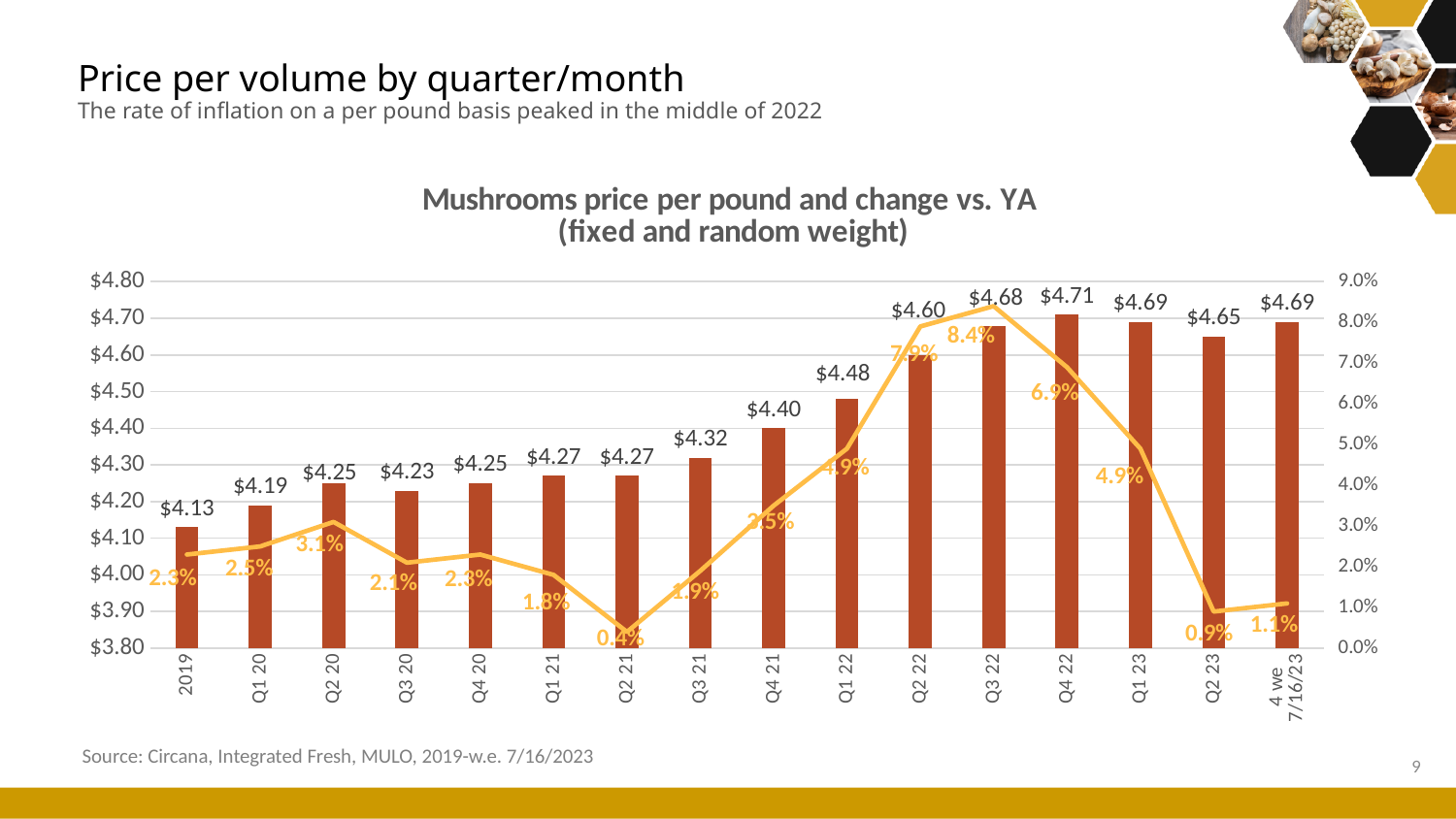
Which period has the highest price per pound? Q4 22 How many periods are shown on the x axis? 16 What is the mushroom price per pound for Q1 23? $4.69 Do prices per pound generally rise or fall from 2019 to Q4 22? Rise What is the difference between the price per pound in Q4 22 and in 2019? $0.58 What kind of chart is this? Combination bar and line chart What is the mushroom price per pound for Q4 21? $4.40 What is the change vs. YA shown for Q3 22? 8.4% Which period has the lowest price per pound? 2019 Which period has the lowest change vs. YA on the line? Q2 21 What is the change vs. YA shown for the 4 weeks ending 7/16/23? 1.1% Which has the higher price per pound, Q2 20 or Q3 20? Q2 20